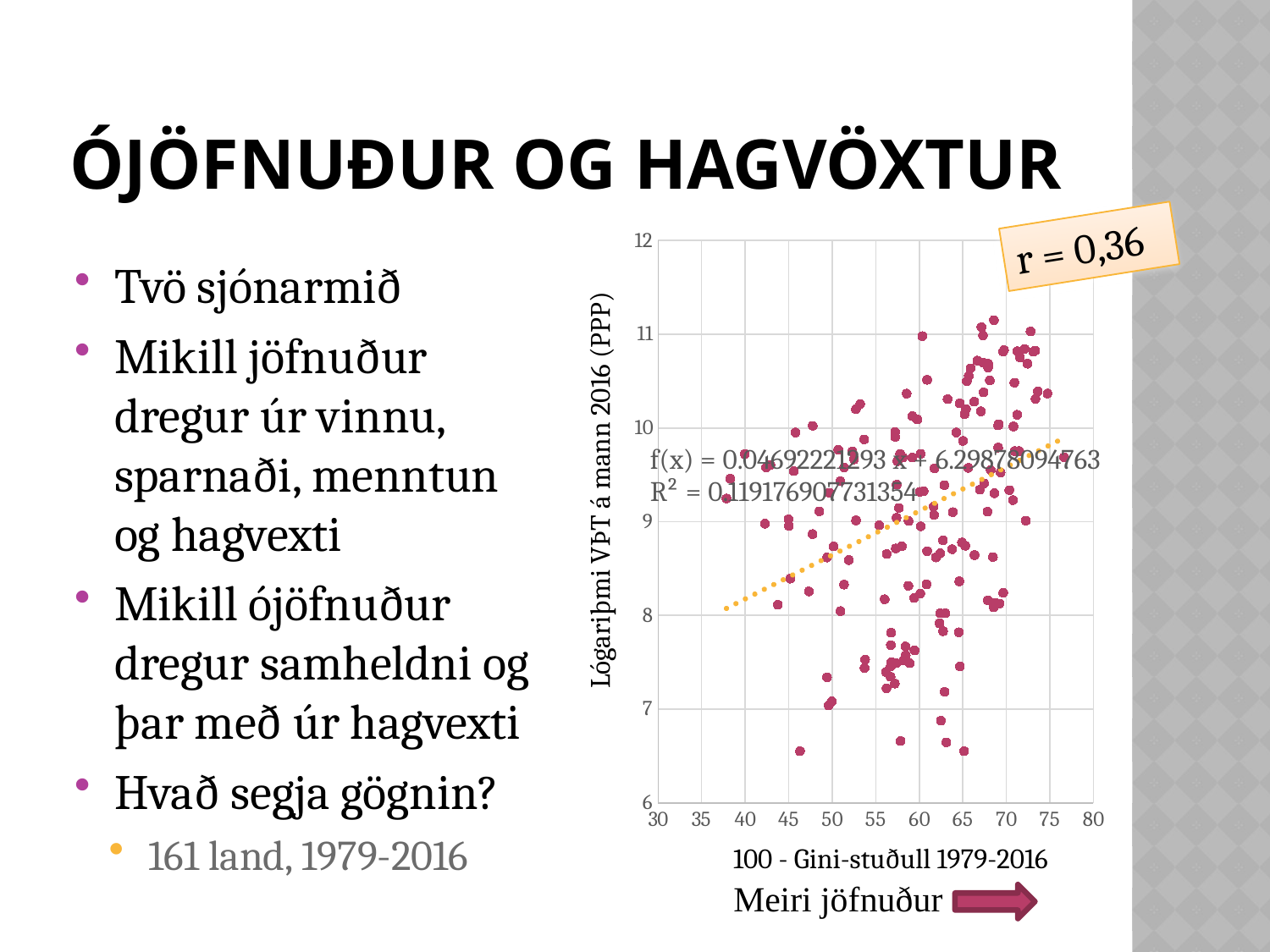
Is the highest plotted point's y value greater or less than 12? less Is the lowest plotted point's y value greater or less than 7? less Does the dotted trend line rise or fall as the x value increases? rises What correlation coefficient r is shown in the callout next to the chart? r = 0,36 What is the label of the x axis of the chart? 100 - Gini-stuðull 1979-2016 Is the leftmost plotted point's x value greater or less than 40? less What is the lowest tick value shown on the x axis? 30 What is the highest tick value shown on the y axis? 12 What R² value is printed on the chart? R² = 0.119176907731354 What kind of chart is shown on the slide? scatter plot What is the label of the y axis of the chart? Lógariþmi VÞT á mann 2016 (PPP)